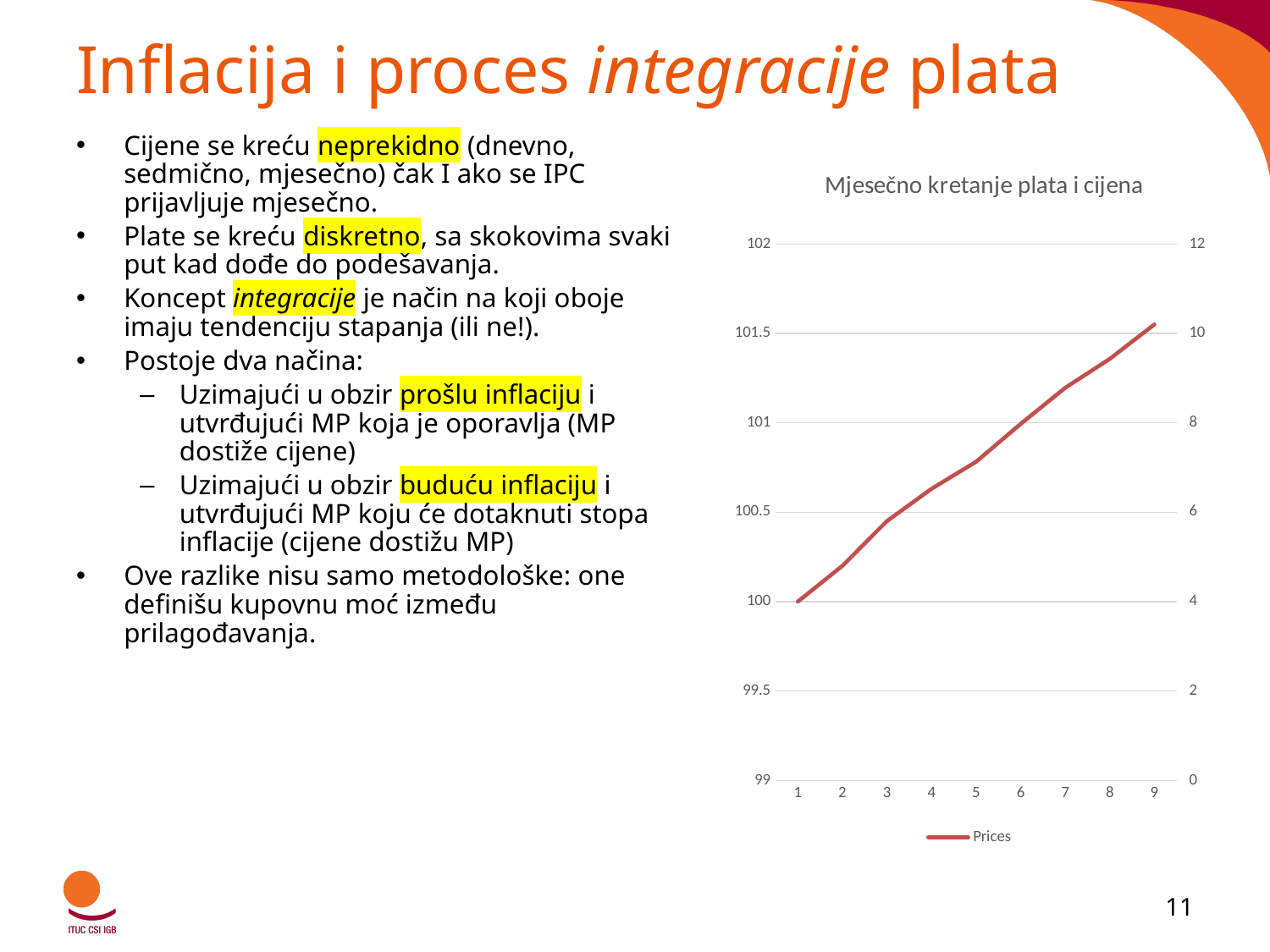
How many series does the chart legend list? 1 Do the Prices values rise or fall from x = 1 to x = 9? rise Is the Prices value at x = 5 greater or less than 101? less What is the name of the series shown in the legend? Prices What is the title of the chart? Mjesečno kretanje plata i cijena At which x value is the Prices line highest? 9 How many points are plotted along the x axis? 9 Is the Prices value at x = 9 greater or less than 101.5? greater Is the Prices value at x = 3 greater or less than 100.5? less What kind of chart is shown on the slide? line chart At which x value is the Prices line lowest? 1 Which is larger, the Prices value at x = 7 or at x = 2? x = 7